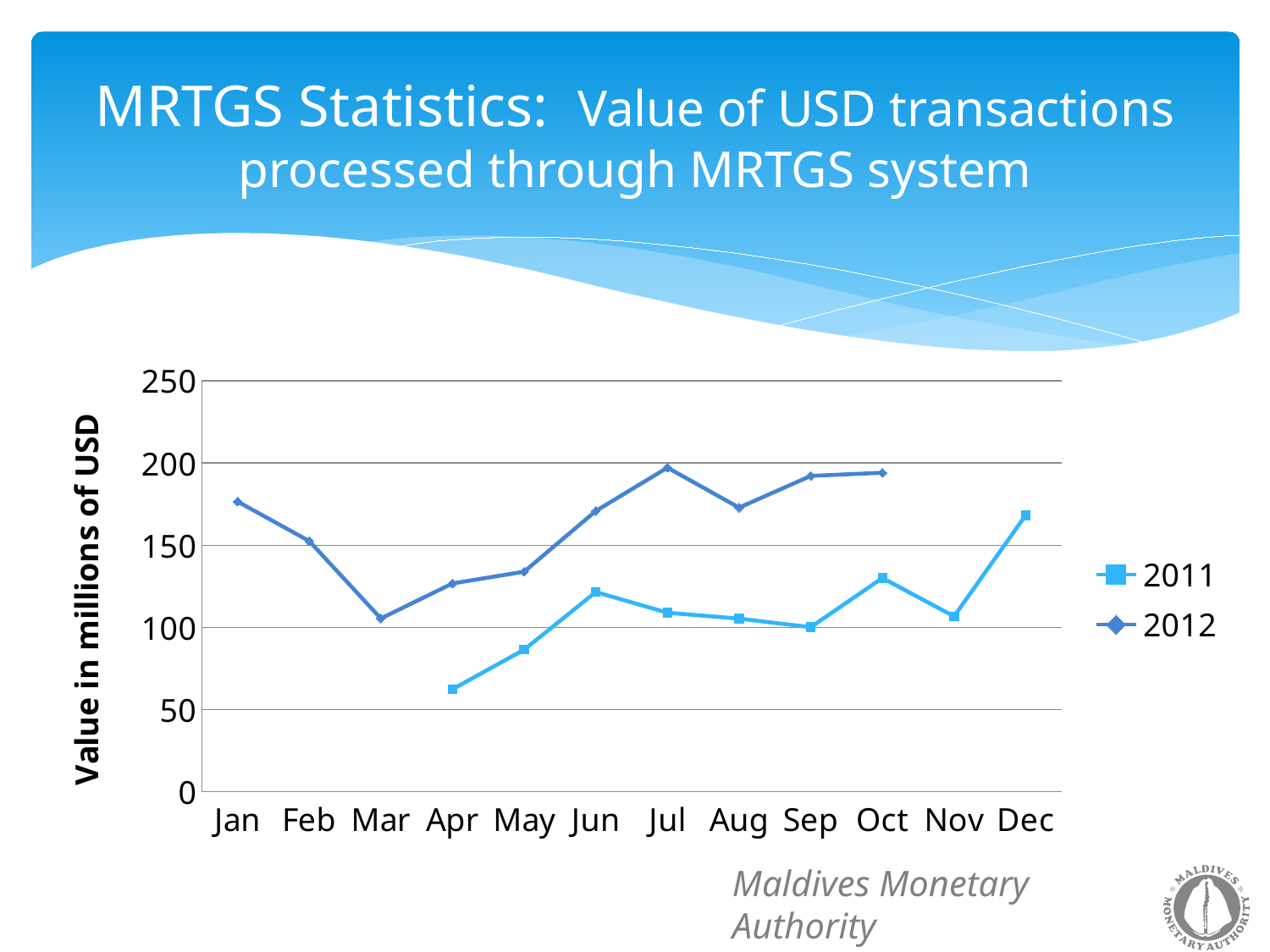
Is the value for 2012 in Jul greater or less than 150? greater Does the 2012 series rise or fall from Jan to Mar? fall Which month has the lowest value for the 2011 series? Apr Is the value for 2012 in Jan greater or less than 150? greater How many months are shown along the x axis? 12 What is the title of the vertical axis? Value in millions of USD What kind of chart is shown on the slide? line chart Which month has the highest value for the 2011 series? Dec Is the value for 2011 in Apr greater or less than 100? less How many series does the legend list? 2 In Jun, which series has the larger value, 2011 or 2012? 2012 Which month has the lowest value for the 2012 series? Mar